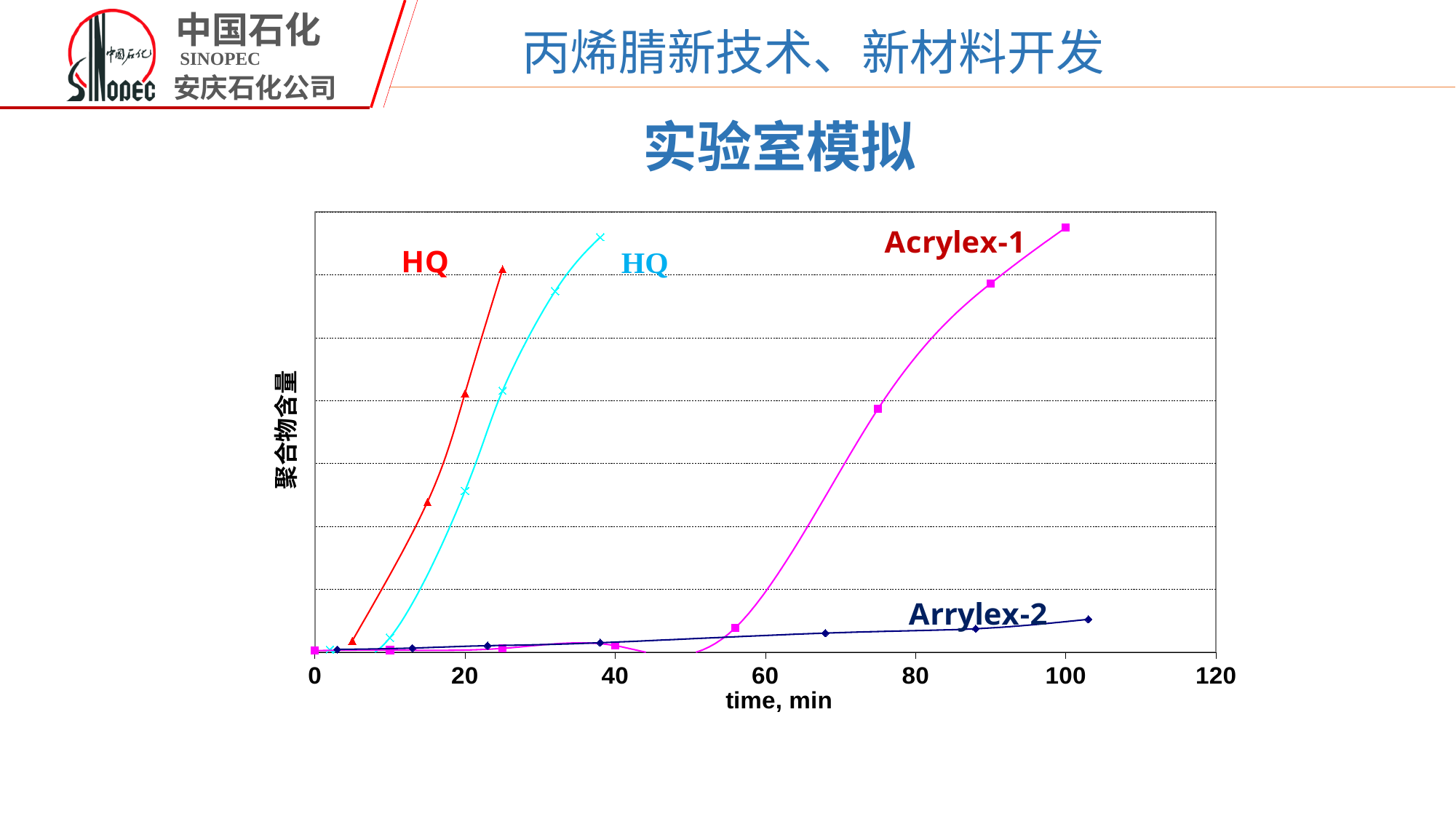
What is the label on the y axis of the chart? 聚合物含量 Which series begins its steep rise latest in time? Acrylex-1 Which series reaches the highest polymer content on the chart? Acrylex-1 What kind of chart is shown on the slide? line chart Which series has the lowest polymer content at the end of its curve? Arrylex-2 At 100 min, which series has the higher value, Acrylex-1 or Arrylex-2? Acrylex-1 Is the last data point of the red HQ series at a time greater or less than 40 min? less At 20 min, which series has the higher value, the red HQ series or the cyan HQ series? red HQ How many data series are labelled on the chart? 4 Does the Acrylex-1 series rise or fall as time increases? rises What is the title of the x axis of the chart? time, min Is the last data point of the Acrylex-1 series at a time greater or less than 80 min? greater